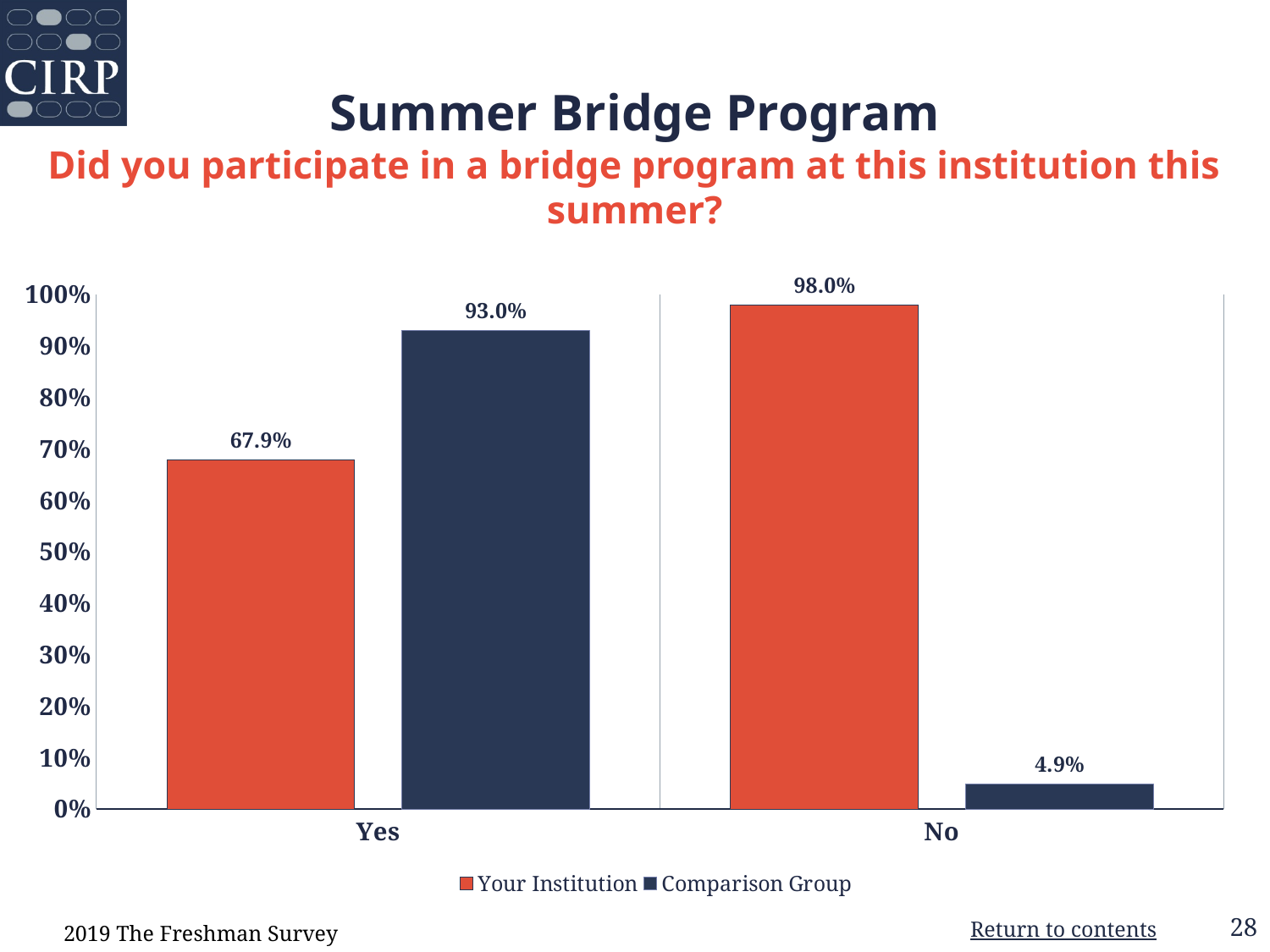
Which colour represents Your Institution in the chart? Orange-red What is the difference between the Comparison Group and Your Institution values in the Yes category? 25.1% Which bar on the chart has the lowest value? Comparison Group, No What is the value for Comparison Group in the Yes category? 93.0% How many categories are shown on the x axis? 2 Which bar on the chart has the highest value? Your Institution, No What is the value for Your Institution in the No category? 98.0% In the Yes category, which series has the larger value, Your Institution or Comparison Group? Comparison Group What is the value for Comparison Group in the No category? 4.9% What is the value for Your Institution in the Yes category? 67.9% What kind of chart is shown on the slide? Bar chart How many series does the legend list? 2